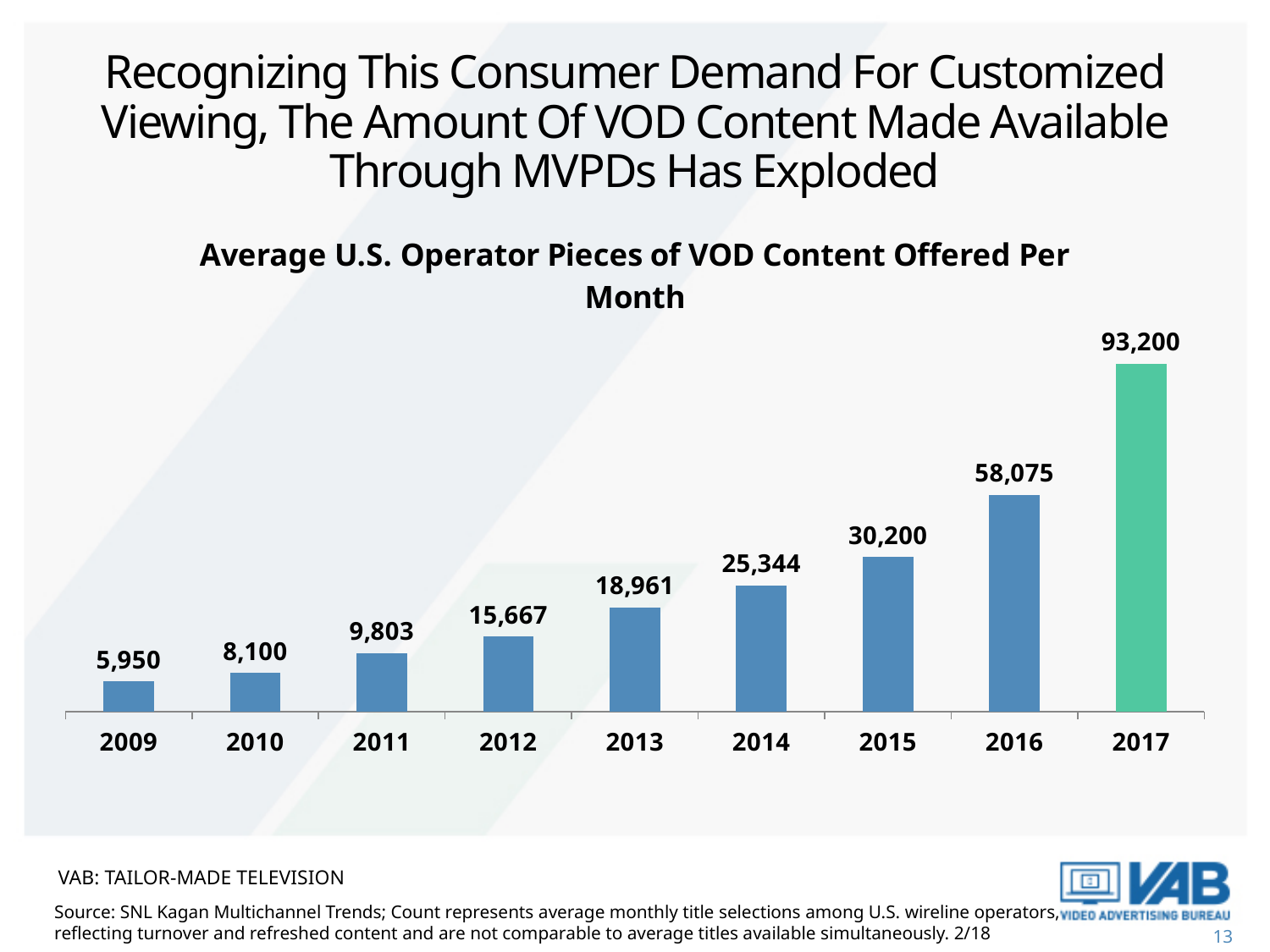
Which year has the highest value? 2017 What is the title of the chart? Average U.S. Operator Pieces of VOD Content Offered Per Month What is the difference between the values for 2017 and 2016? 35,125 Do the values rise or fall from 2009 to 2017? rise What is the value for 2009? 5,950 Which year has the lowest value? 2009 How many years are shown on the x axis? 9 What is the difference between the values for 2015 and 2014? 4,856 Which is larger, the value for 2012 or the value for 2011? 2012 What is the value for 2013? 18,961 What is the value for 2016? 58,075 What kind of chart is shown? bar chart